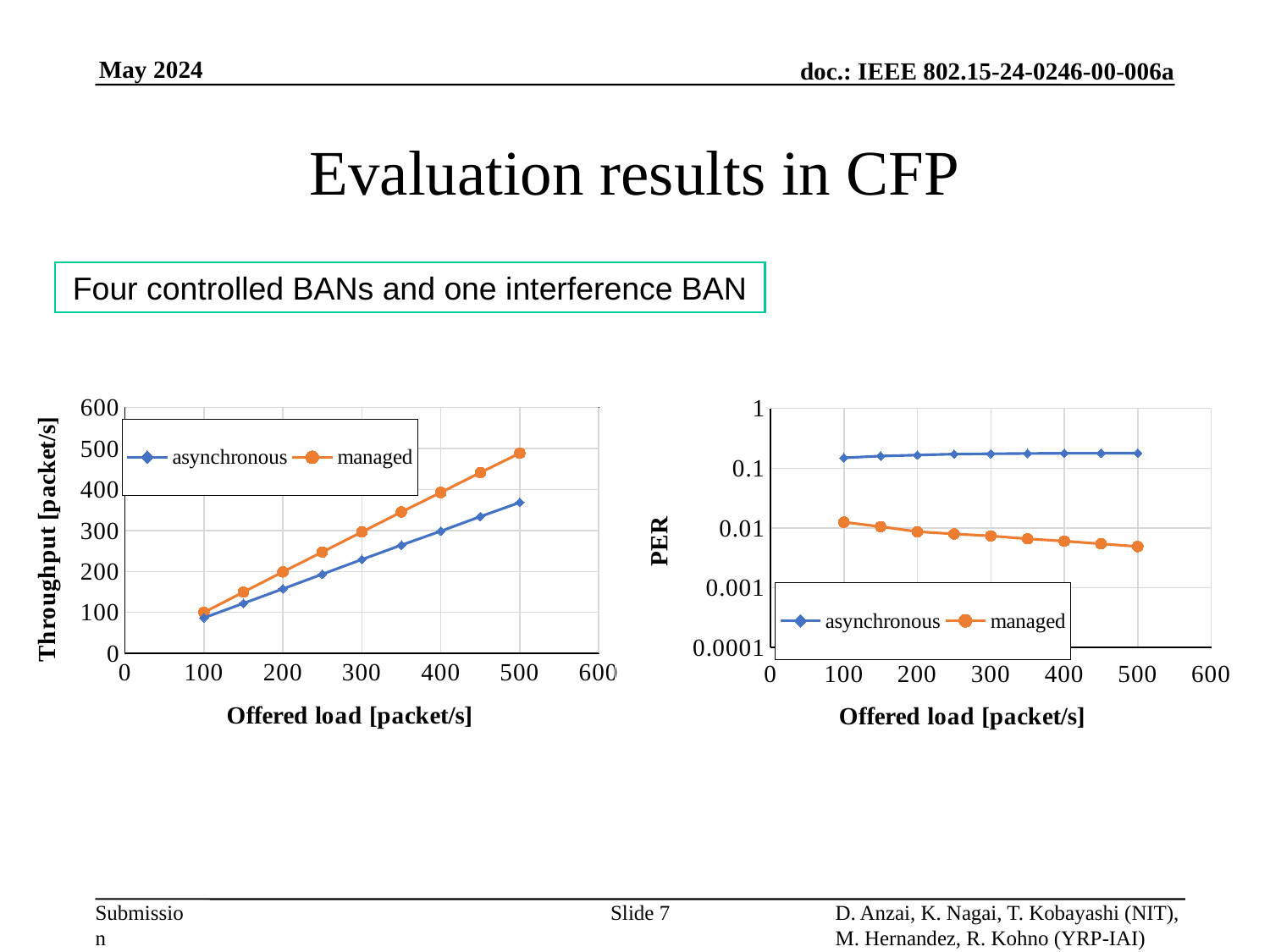
In the left chart (Throughput vs Offered load), does the throughput of the managed series rise or fall as offered load increases? rise In the left chart (Throughput vs Offered load), is the throughput for asynchronous at an offered load of 200 greater or less than 200? less In the left chart (Throughput vs Offered load), which series has the higher throughput at an offered load of 500, asynchronous or managed? managed In the left chart (Throughput vs Offered load), how many data points does the managed series have? 9 In the left chart (Throughput vs Offered load), is the throughput for asynchronous at an offered load of 500 greater or less than 400? less In the right chart (PER vs Offered load), is the PER for managed at an offered load of 500 greater or less than 0.01? less What kind of chart is the left chart (Throughput vs Offered load)? line chart How many series does the legend of the right chart (PER vs Offered load) list? 2 In the right chart (PER vs Offered load), which series has the higher PER at an offered load of 300, asynchronous or managed? asynchronous In the right chart (PER vs Offered load), does the PER of the managed series rise or fall as offered load increases? fall